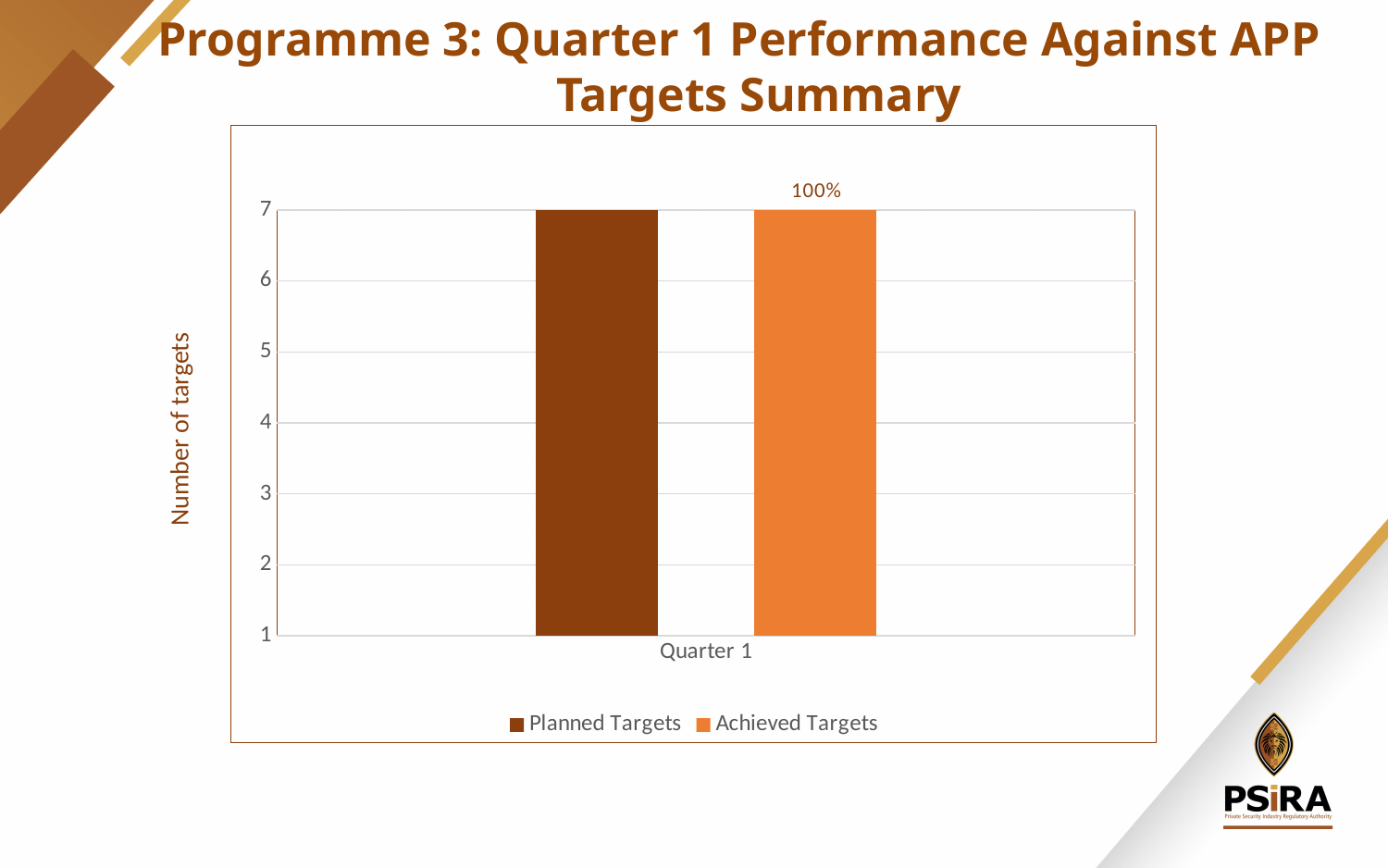
What percentage label is shown above the Achieved Targets bar? 100% Is the value for Planned Targets in Quarter 1 greater or less than 4? greater What is the difference between Planned Targets and Achieved Targets for Quarter 1? 0 How many categories are shown on the x axis? 1 What is the name of the category on the x axis? Quarter 1 Is the value for Achieved Targets in Quarter 1 greater or less than 5? greater How many series does the legend list? 2 What is the label of the y axis? Number of targets What is the value of Planned Targets for Quarter 1? 7 What kind of chart is shown on the slide? bar chart What is the value of Achieved Targets for Quarter 1? 7